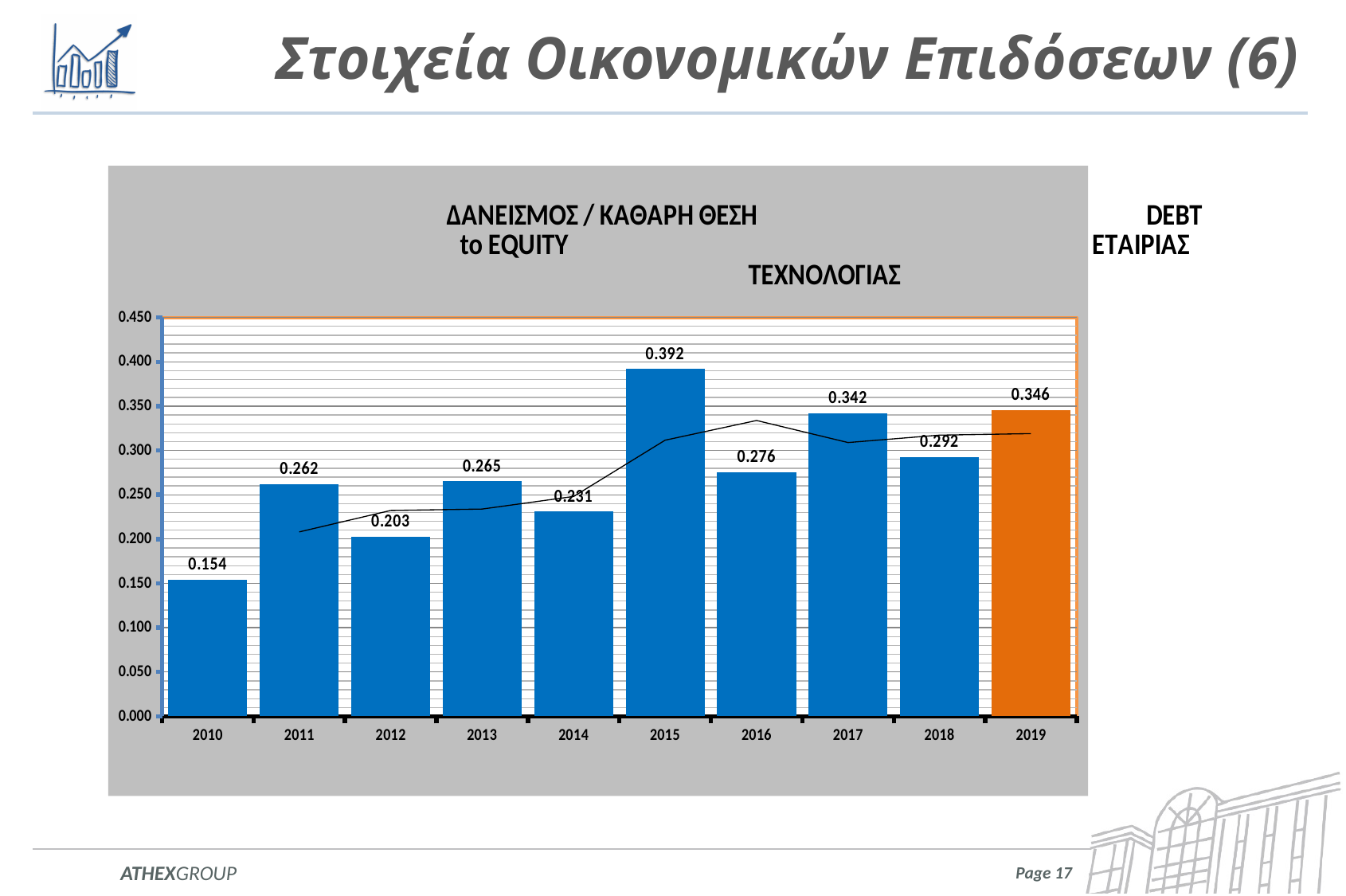
What is the value for 2015? 0.392 What is the value for 2010? 0.154 What is the value for 2019? 0.346 Which year has the highest value? 2015 Which is larger, the value for 2017 or the value for 2016? 2017 Which year has the lowest value? 2010 What colour is the bar for 2019? orange How many years are shown on the x axis? 10 What is the value for 2012? 0.203 What kind of chart is this? bar chart What is the difference between the values for 2015 and 2010? 0.238 What is the difference between the values for 2019 and 2018? 0.054